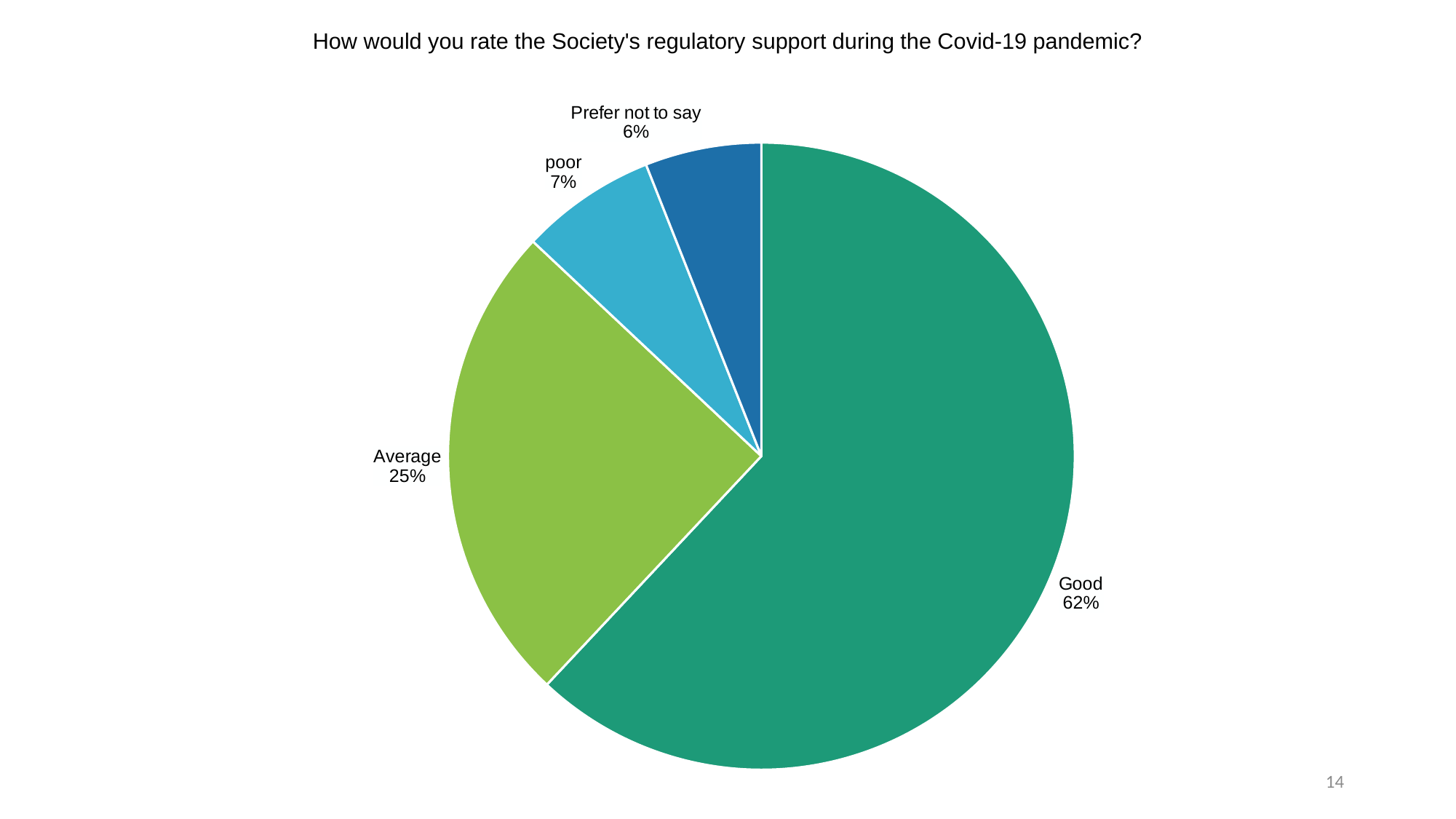
What is the difference in percentage points between the poor and Prefer not to say slices? 1 What percentage of respondents rated the support as Average? 25% Which rating category has the largest slice of the pie? Good Which is larger, the Average slice or the poor slice? Average What kind of chart is shown on the slide? Pie chart How many categories are shown in the pie chart? 4 What is the difference in percentage points between the Good and Average slices? 37 What percentage of respondents rated the Society's regulatory support as Good? 62% What share of respondents chose 'Prefer not to say'? 6% What is the title of the chart? How would you rate the Society's regulatory support during the Covid-19 pandemic? Which category has the smallest slice of the pie? Prefer not to say What percentage of respondents rated the support as poor? 7%